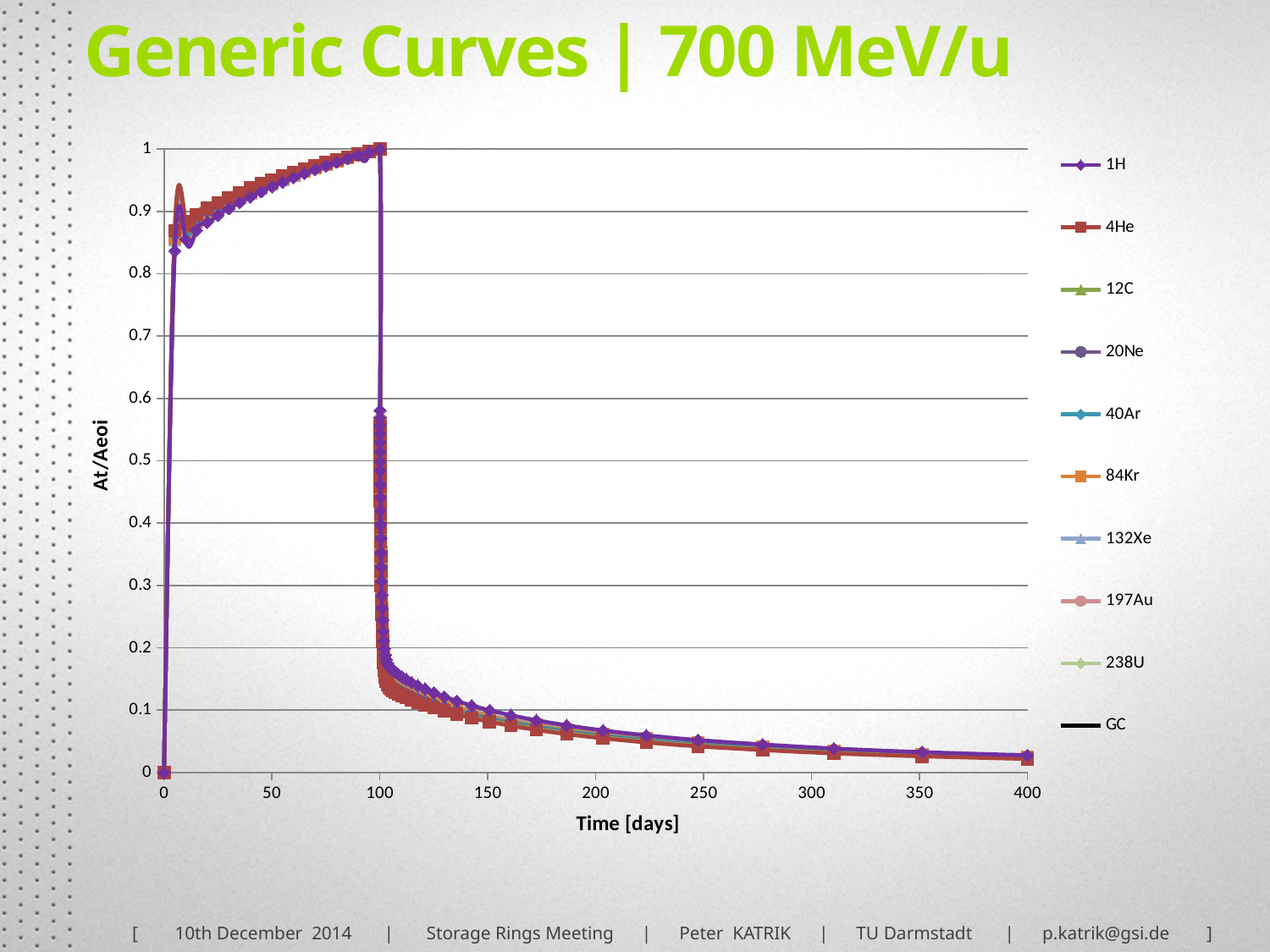
Which is larger, the value of the curves at 50 days or at 150 days? 50 days Is the value of the curves at 400 days greater or less than 0.1? less Do the curves rise or fall between 100 and 400 days? fall Is the value of the curves at 300 days greater or less than 0.1? less Do the curves rise or fall between 20 and 100 days? rise What is the title of the chart? Generic Curves | 700 MeV/u Is the value of the curves at 200 days greater or less than 0.2? less At what time in days do the curves reach their peak value of 1? 100 How many series does the legend list? 10 What kind of chart is shown on the slide? line chart What is the label of the x axis? Time [days]